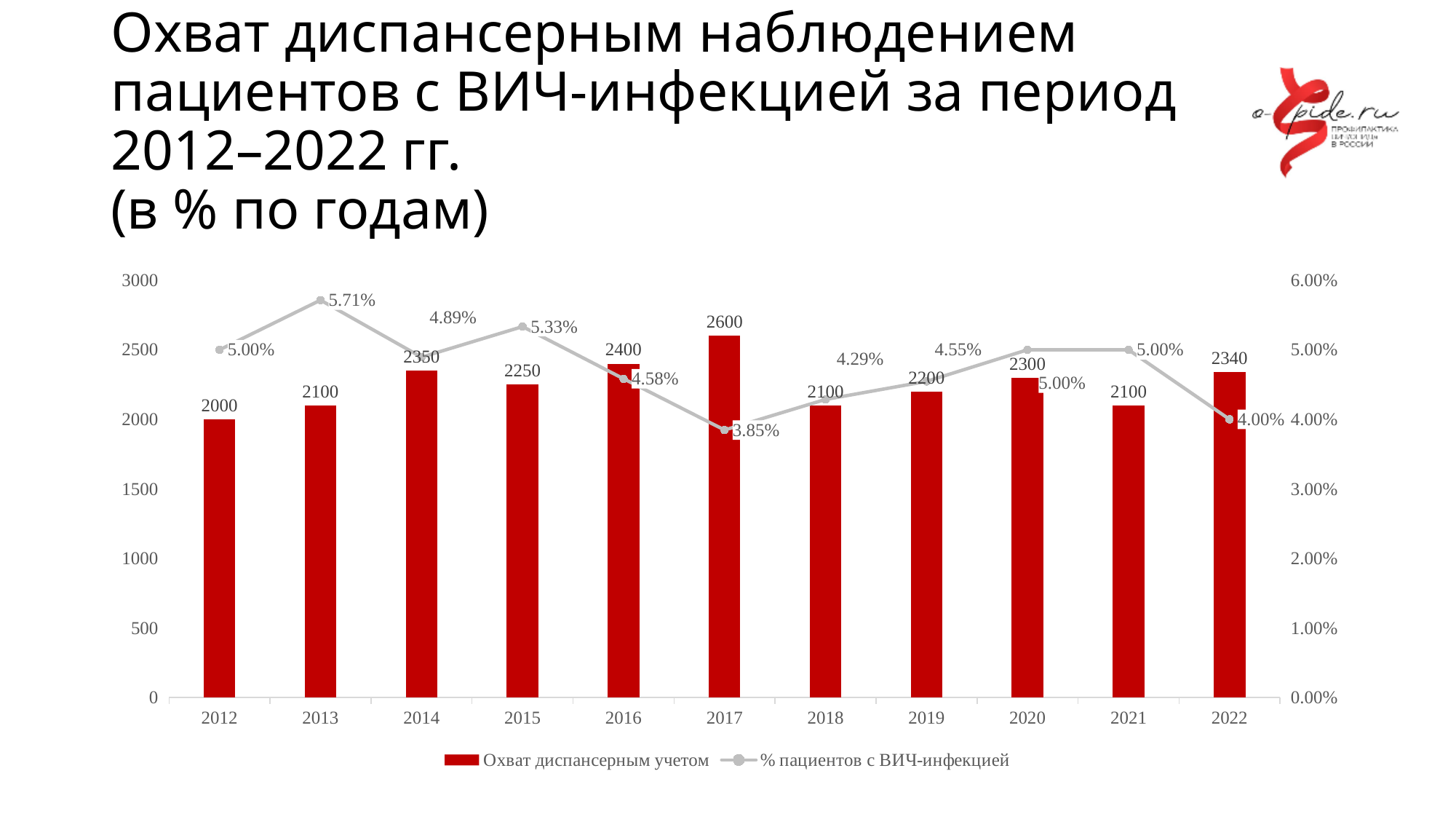
In which year is "Охват диспансерным учетом" highest? 2017 In which year is "% пациентов с ВИЧ-инфекцией" lowest? 2017 How many years are shown on the x axis? 11 What is the value of "Охват диспансерным учетом" for 2022? 2340 What is the difference between "Охват диспансерным учетом" in 2017 and in 2012? 600 What kind of chart is shown on the slide? Combined bar and line chart What is the value of "Охват диспансерным учетом" for 2017? 2600 Is the value of "Охват диспансерным учетом" for 2019 greater or less than 2500? less Does "% пациентов с ВИЧ-инфекцией" rise or fall from 2013 to 2017? fall How many series does the legend list? 2 What is the value of "% пациентов с ВИЧ-инфекцией" for 2013? 5.71% Which year has a larger value of "Охват диспансерным учетом": 2014 or 2015? 2014